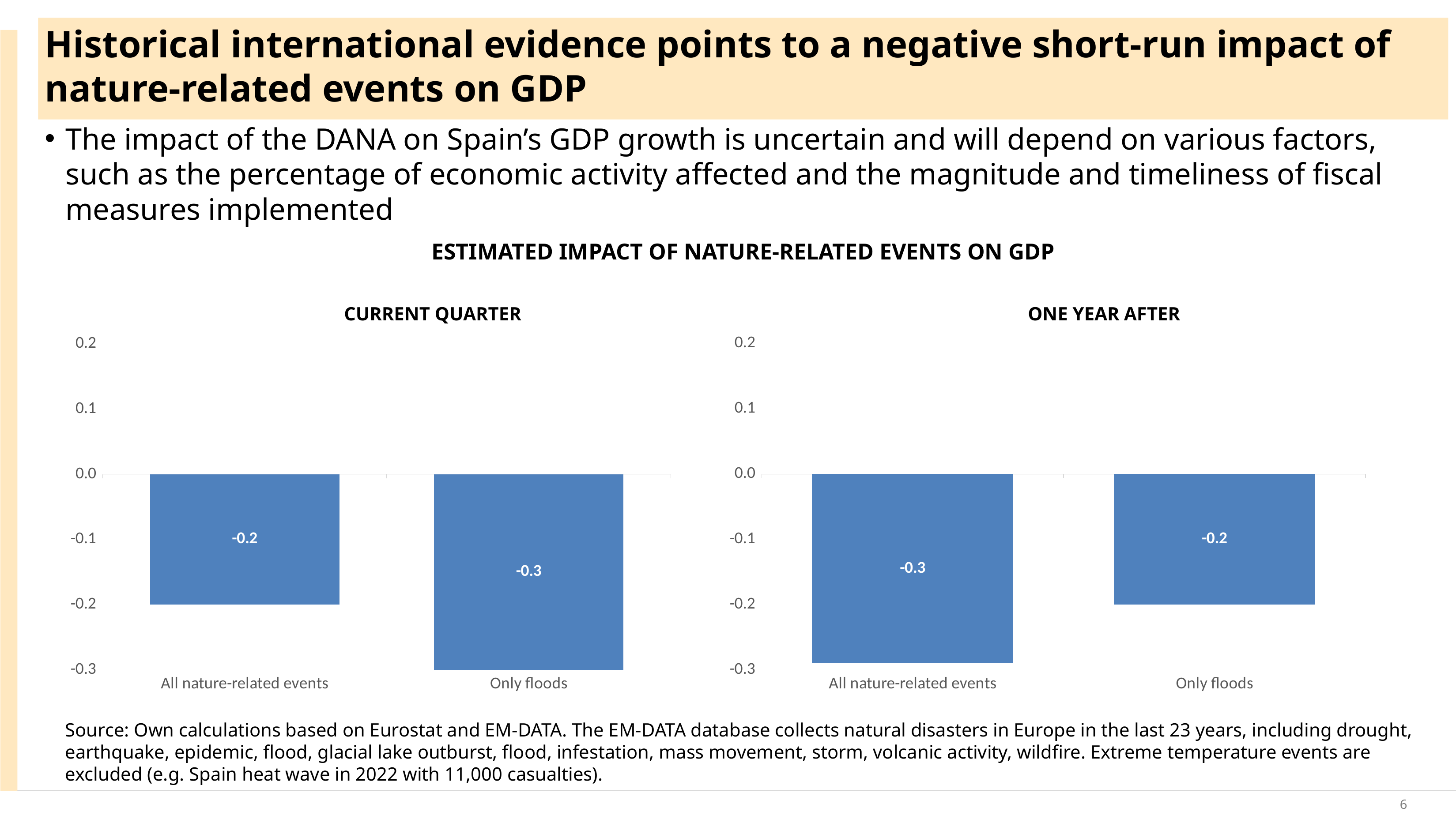
In the CURRENT QUARTER chart, what is the difference between the value for All nature-related events and the value for Only floods? 0.1 In the ONE YEAR AFTER chart, which category has the lowest value? All nature-related events In the ONE YEAR AFTER chart, what is the value for Only floods? -0.2 What is the overall title above the two charts? ESTIMATED IMPACT OF NATURE-RELATED EVENTS ON GDP In the ONE YEAR AFTER chart, what is the value for All nature-related events? -0.3 What kind of chart is the ONE YEAR AFTER chart? Bar chart In the CURRENT QUARTER chart, which category has the lowest value? Only floods In the CURRENT QUARTER chart, what is the value for Only floods? -0.3 In the CURRENT QUARTER chart, what is the value for All nature-related events? -0.2 In the CURRENT QUARTER chart, is the value for Only floods greater or less than -0.2? less In the ONE YEAR AFTER chart, which is larger: the value for All nature-related events or the value for Only floods? Only floods How many categories are shown in the CURRENT QUARTER chart? 2